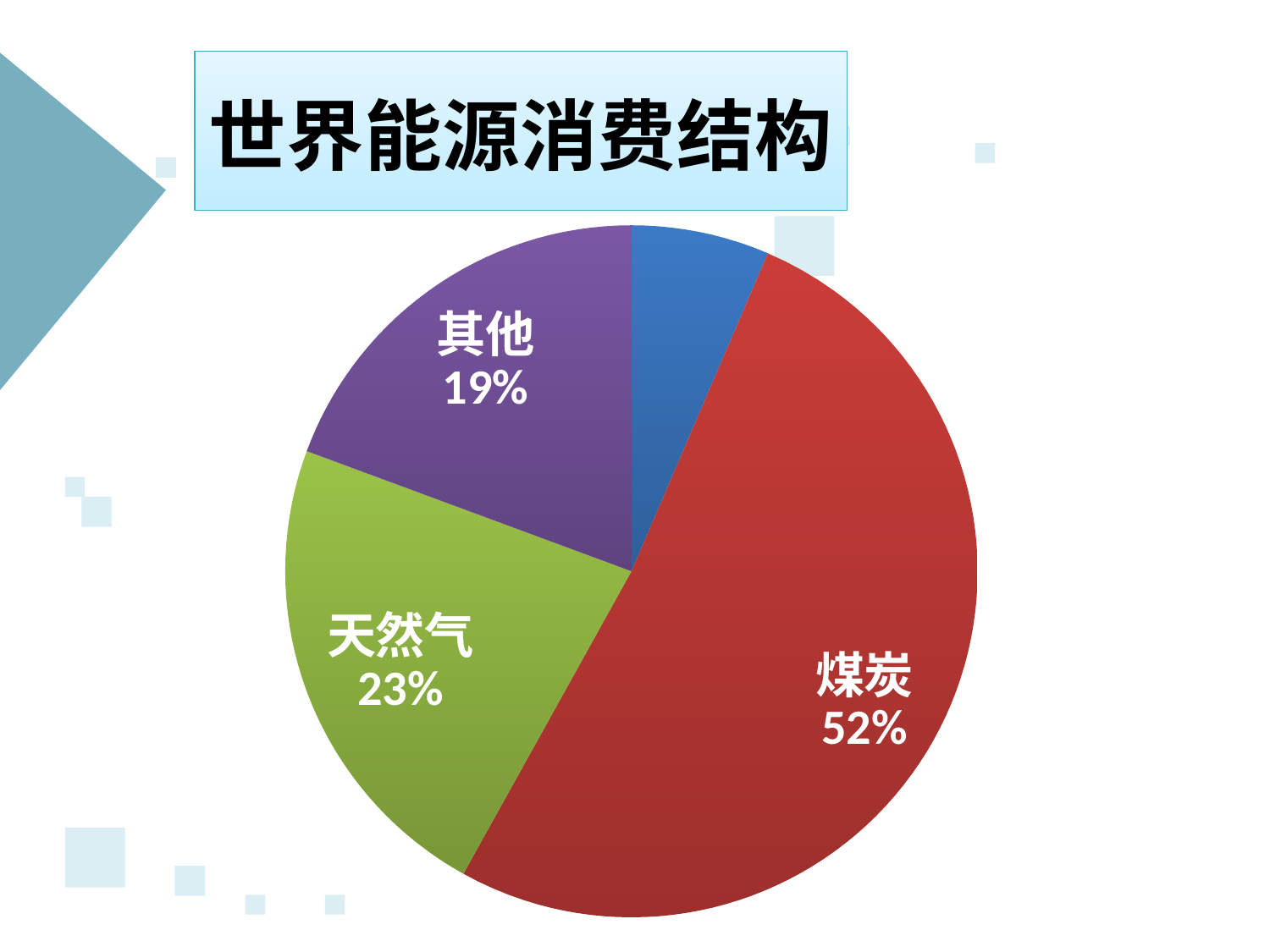
What is the difference in percentage points between 天然气 and 其他? 4 How many slices does the pie chart have? 4 What colour is the 煤炭 slice? Red What type of chart is shown on the slide? Pie chart What value is shown for the 其他 slice? 19% What percentage of the pie chart is 煤炭? 52% Which category has the largest slice of the pie? 煤炭 How many percentage points larger is 煤炭 than 天然气? 29 What percentage does 天然气 account for in the chart? 23% What is the title of the chart? 世界能源消费结构 Which is larger, the share of 天然气 or the share of 其他? 天然气 Among the labeled slices, which category has the smallest share? 其他